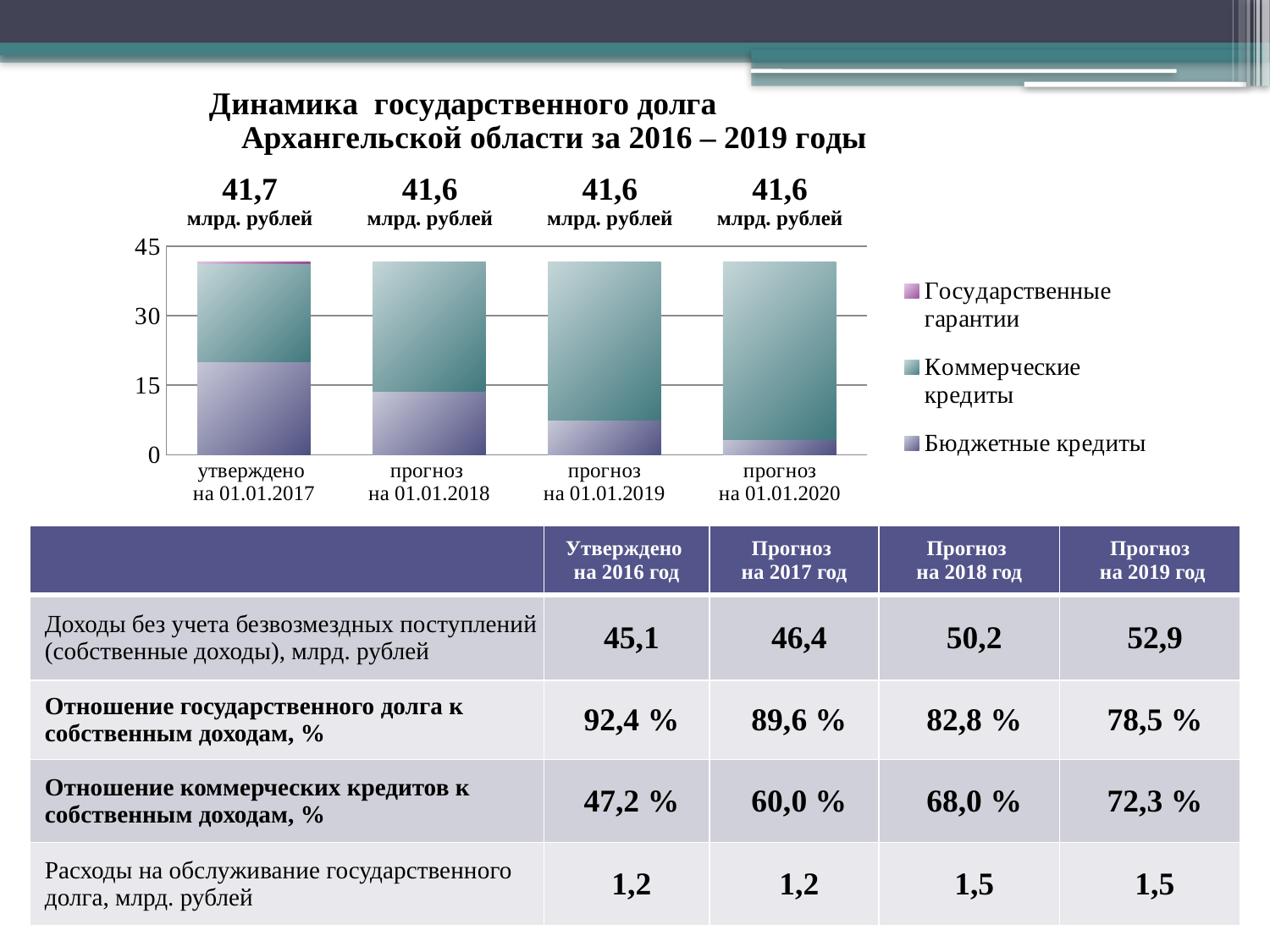
How many series does the chart legend list? 3 What kind of chart is shown on the slide? stacked bar chart Is the value of "Бюджетные кредиты" for "утверждено на 01.01.2017" greater or less than 15? greater What is the total state debt shown above the bar for "прогноз на 01.01.2020"? 41,6 млрд. рублей Which is larger: "Бюджетные кредиты" for 01.01.2017 or "Бюджетные кредиты" for 01.01.2020? 01.01.2017 Which series is shown in the lightest (pink) colour in the legend? Государственные гарантии Is the value of "Бюджетные кредиты" for "прогноз на 01.01.2020" greater or less than 15? less Do the values of "Бюджетные кредиты" rise or fall from 01.01.2017 to 01.01.2020? fall What is the total state debt shown above the bar for "утверждено на 01.01.2017"? 41,7 млрд. рублей What is the difference between the total debt for 01.01.2017 and the total debt for 01.01.2018? 0,1 млрд. рублей How many bars (periods) does the chart show? 4 Which period has the highest total state debt according to the labels above the bars? утверждено на 01.01.2017